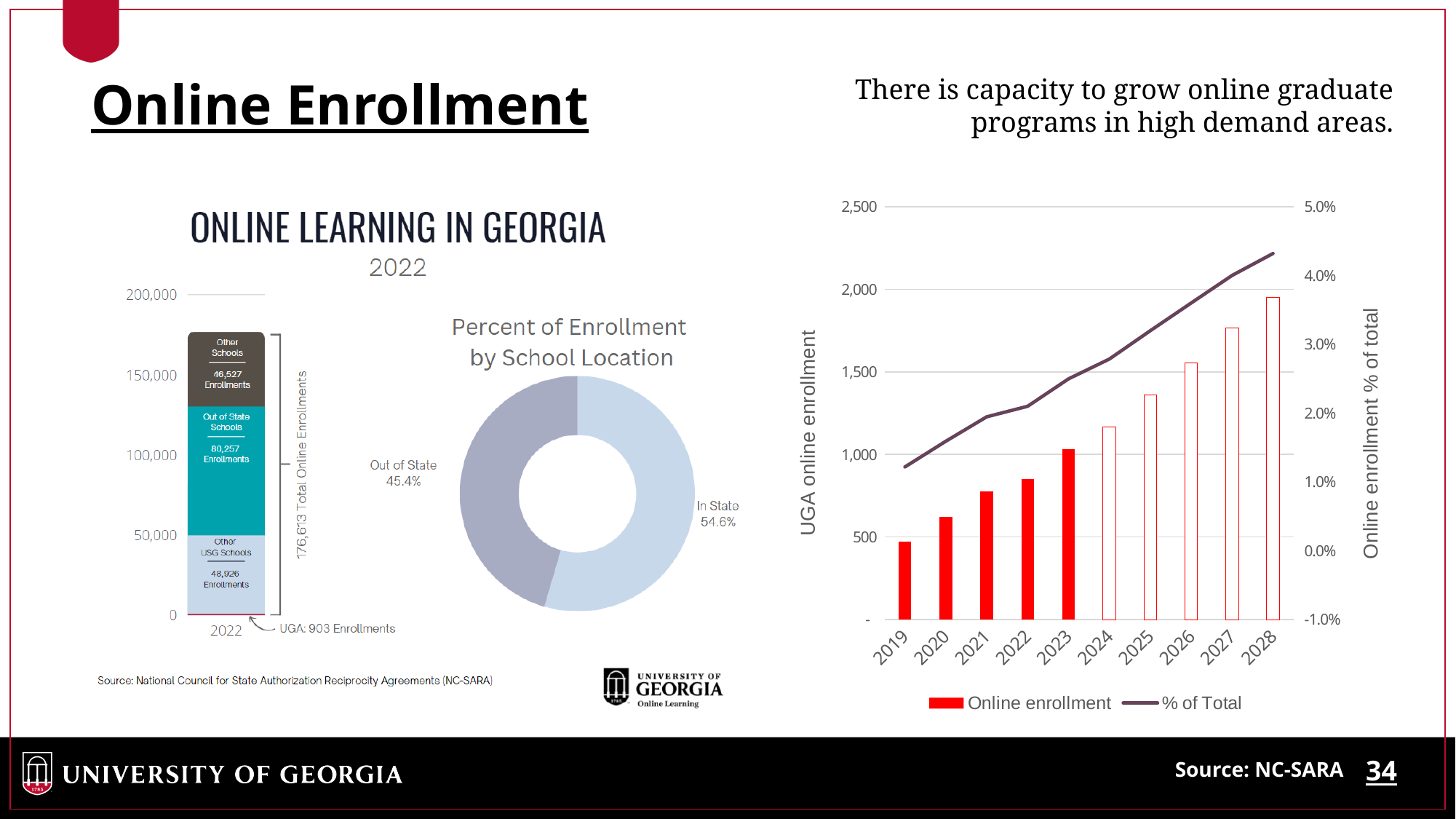
In the 'Online Learning in Georgia 2022' stacked bar chart, how many enrollments are shown for Out of State Schools? 80,257 In the 'Online Learning in Georgia 2022' stacked bar chart, how many enrollments are attributed to UGA? 903 In the 'Online Learning in Georgia 2022' stacked bar chart, which segment has the most enrollments? Out of State Schools In the UGA online enrollment chart on the right, does online enrollment rise or fall from 2019 to 2028? Rise In the UGA online enrollment chart on the right, how many series does the legend list? 2 What kind of chart is the UGA online enrollment chart on the right of the slide? Bar and line chart In the 'Percent of Enrollment by School Location' donut chart, which is larger, In State or Out of State? In State In the 'Online Learning in Georgia 2022' stacked bar chart, what is the total number of online enrollments shown for the bar? 176,613 In the UGA online enrollment chart on the right, how many years are shown on the x axis? 10 In the 'Online Learning in Georgia 2022' stacked bar chart, what is the difference between Out of State Schools enrollments and Other USG Schools enrollments? 31,331 In the 'Percent of Enrollment by School Location' donut chart, what share is In State? 54.6% In the UGA online enrollment chart on the right, is the online enrollment value for 2019 greater or less than 500? less